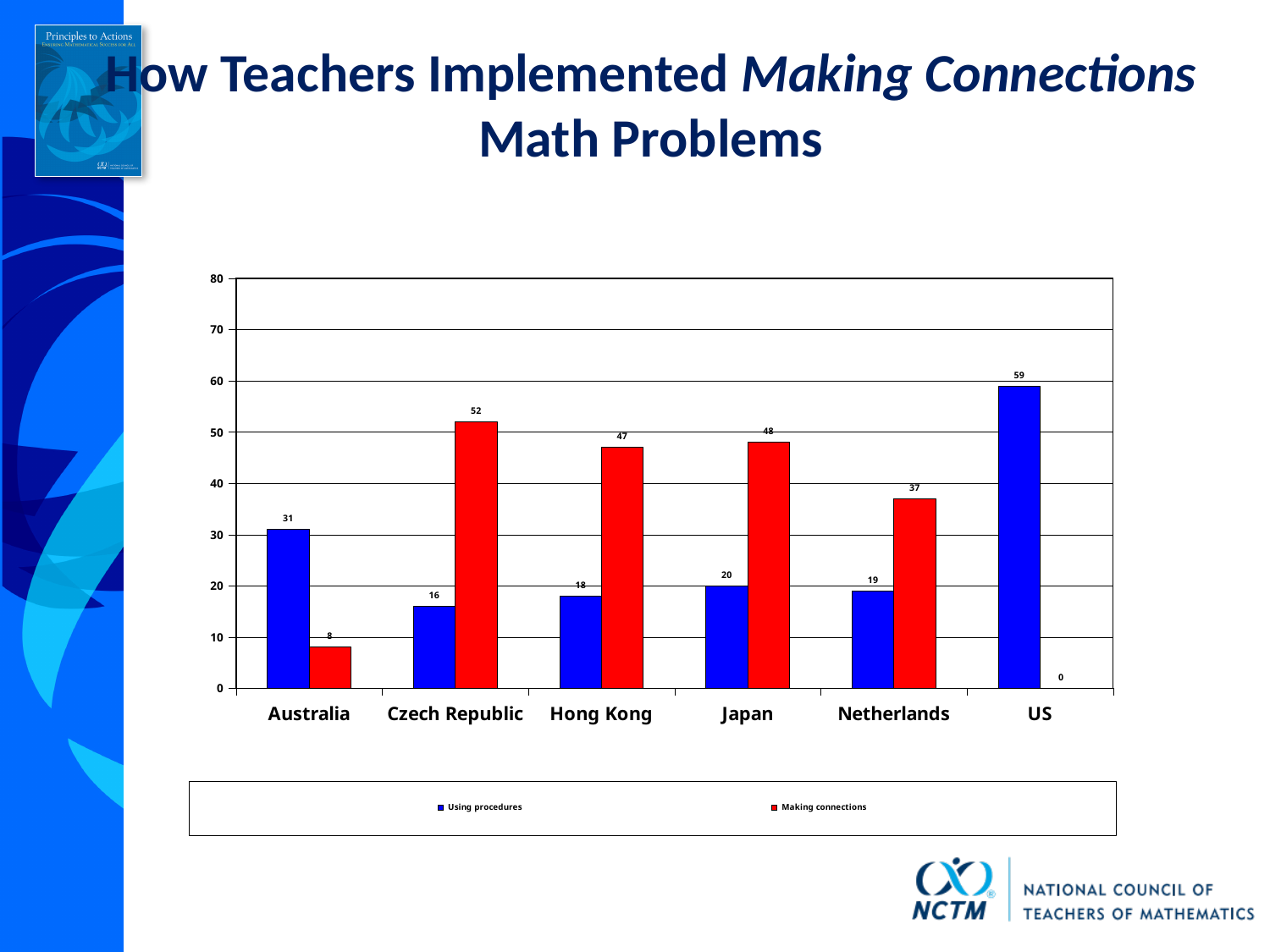
Which colour represents Making connections in the legend? red What is the value for Making connections in Australia? 8 Which country has the highest value for Making connections? Czech Republic How many series does the legend list? 2 Is the value for Using procedures in the US greater or less than 50? greater Which country has the lowest value for Using procedures? Czech Republic What is the value for Making connections in the Czech Republic? 52 What kind of chart is shown on the slide? bar chart How many countries are shown on the x axis? 6 What is the difference between Making connections and Using procedures in Japan? 28 Which is larger in the Netherlands, Using procedures or Making connections? Making connections What is the value for Using procedures in the US? 59